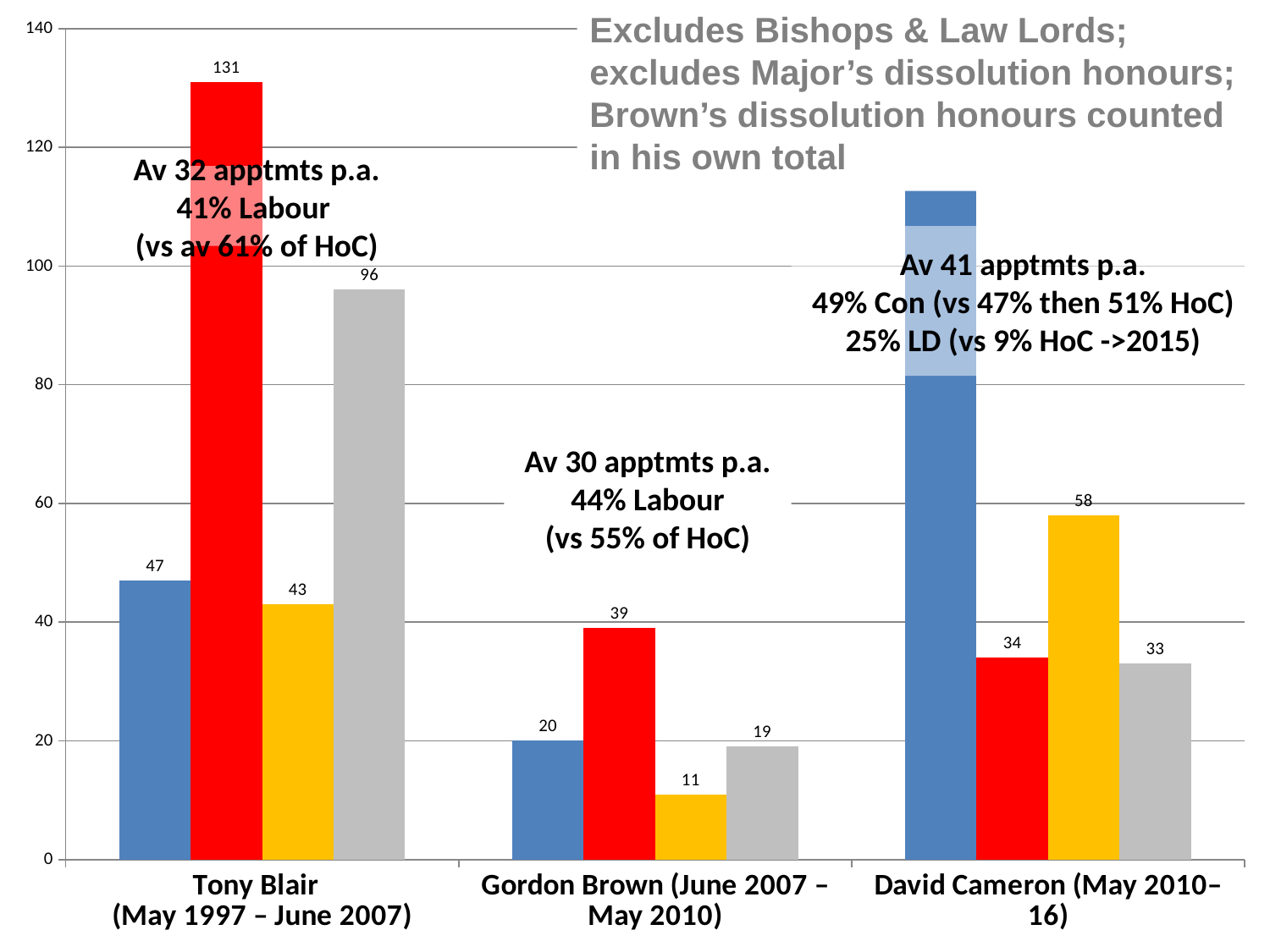
What kind of chart is shown on the slide? Bar chart Which is larger: the red bar for Gordon Brown or the red bar for David Cameron? Gordon Brown (June 2007 – May 2010) Which prime minister has the highest red bar? Tony Blair (May 1997 – June 2007) What is the value of the yellow bar for David Cameron (May 2010–16)? 58 What is the value of the red bar for Tony Blair (May 1997 – June 2007)? 131 Is the value of the blue bar for David Cameron (May 2010–16) greater or less than 100? greater How many prime ministers (categories) are shown on the x axis? 3 What is the value of the grey bar for Gordon Brown (June 2007 – May 2010)? 19 What is the difference between the grey bar for Tony Blair and the grey bar for David Cameron? 63 What is the value of the blue bar for Gordon Brown (June 2007 – May 2010)? 20 Which prime minister has the lowest yellow bar? Gordon Brown (June 2007 – May 2010) How do the values of the red bars change from Tony Blair to Gordon Brown to David Cameron? They fall from 131 to 39, then fall to 34